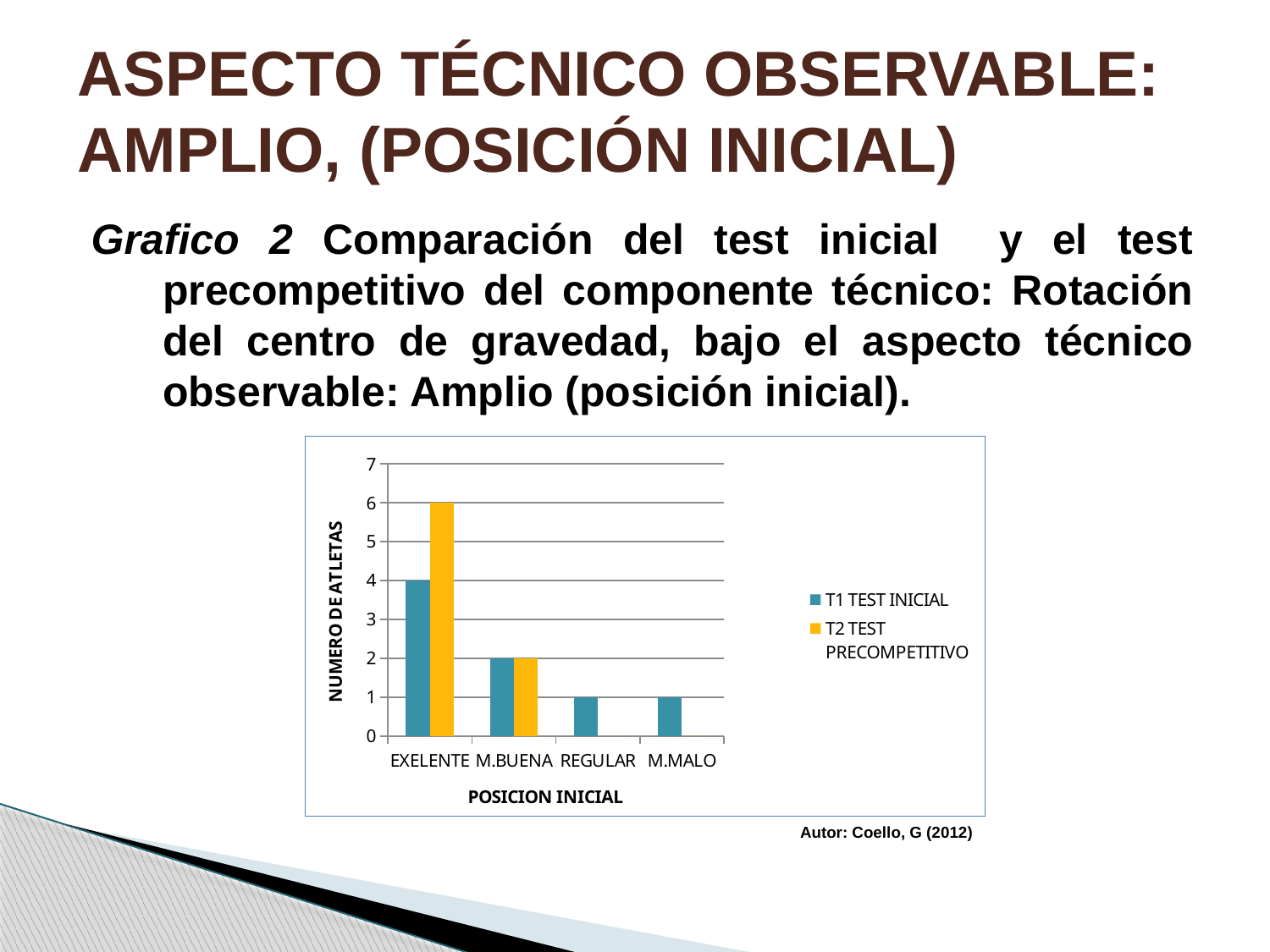
For EXELENTE, which series has the larger value, T1 TEST INICIAL or T2 TEST PRECOMPETITIVO? T2 TEST PRECOMPETITIVO Do the T1 TEST INICIAL values rise or fall from EXELENTE to REGULAR along the x axis? fall What kind of chart is shown on the slide? bar chart What is the value for M.BUENA in the T1 TEST INICIAL series? 2 What is the value for REGULAR in the T1 TEST INICIAL series? 1 Which category has the highest value in the T2 TEST PRECOMPETITIVO series? EXELENTE How many categories are shown on the x axis? 4 What is the value for EXELENTE in the T1 TEST INICIAL series? 4 What is the label of the y axis? NUMERO DE ATLETAS What is the difference between the T2 TEST PRECOMPETITIVO and T1 TEST INICIAL values for EXELENTE? 2 What is the value for EXELENTE in the T2 TEST PRECOMPETITIVO series? 6 How many series does the legend list? 2